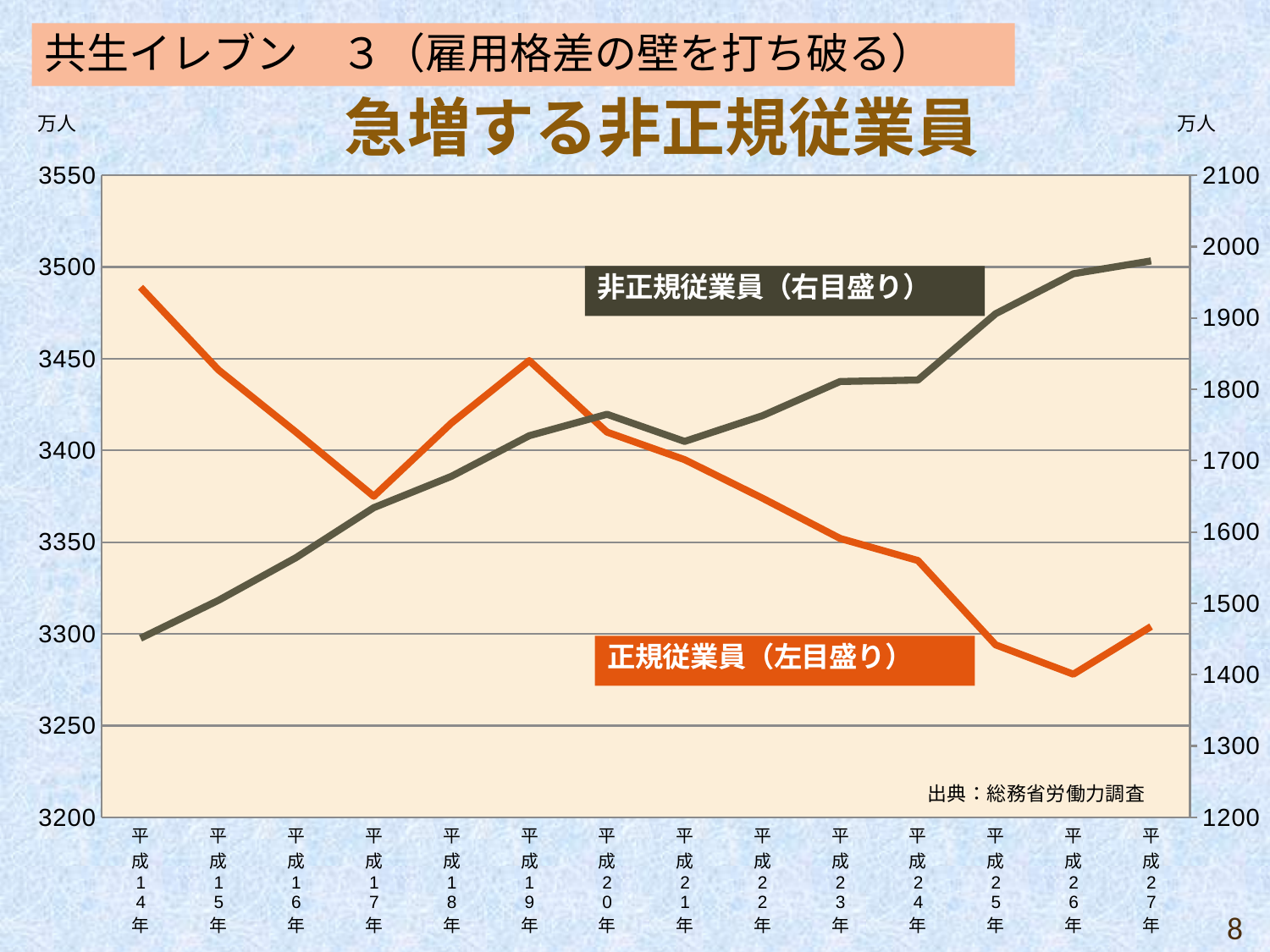
How many years are shown along the x axis of the chart? 14 Does the 非正規従業員 line rise or fall overall from 平成14年 to 平成27年? rise Is the 正規従業員 value for 平成14年 greater or less than 3450? greater In which year is the 正規従業員 value lowest? 平成26年 In which year is the 正規従業員 value highest? 平成14年 What is the title of the chart? 急増する非正規従業員 Does the 正規従業員 line rise or fall overall from 平成14年 to 平成27年? fall Is the 非正規従業員 value for 平成27年 greater or less than 1900? greater What kind of chart is shown on the slide? line chart In which year is the 非正規従業員 value highest? 平成27年 Which is larger, the 正規従業員 value for 平成19年 or for 平成20年? 平成19年 How many series are plotted on the chart? 2